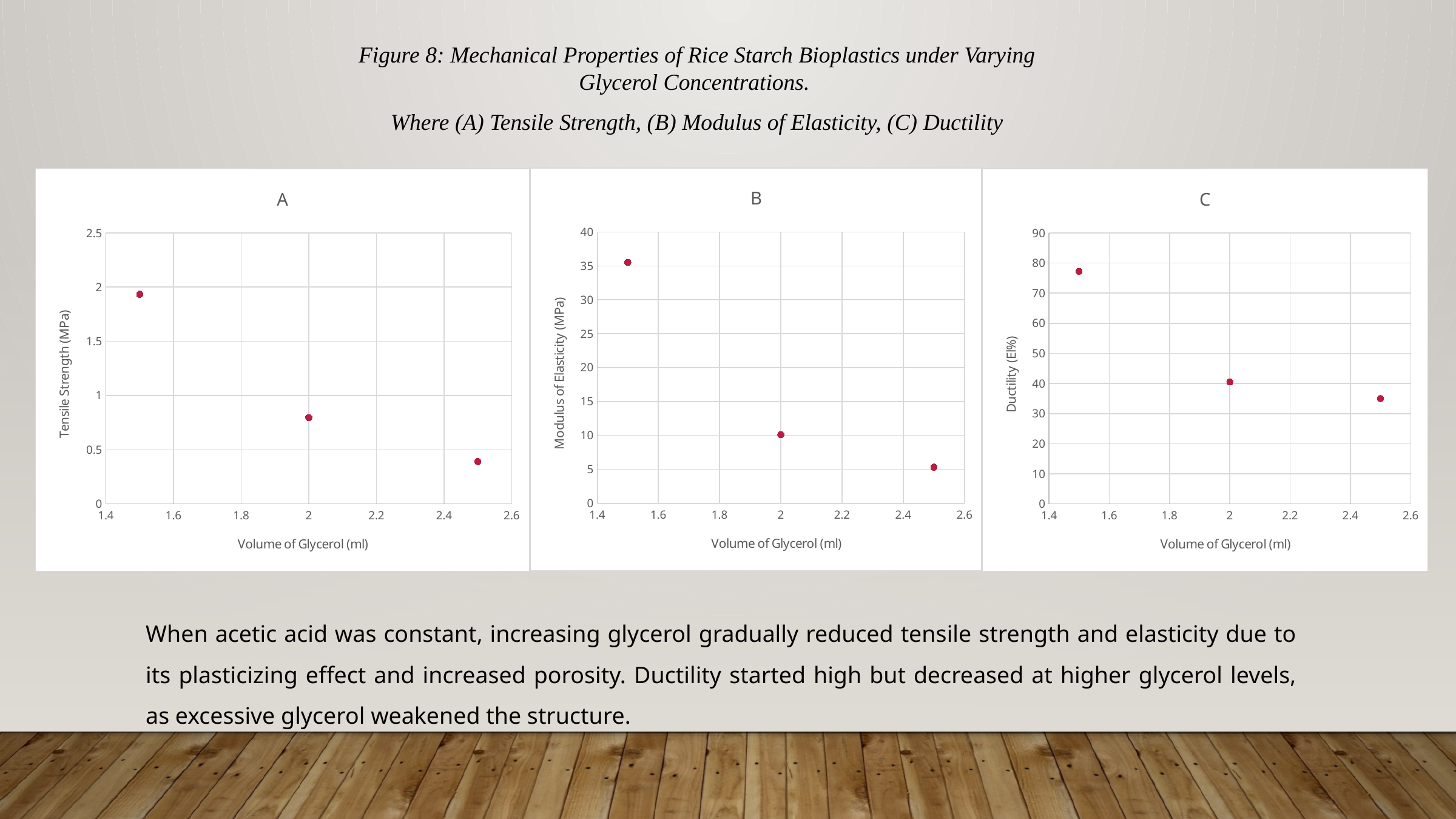
In chart C, is the ductility at 1.5 ml of glycerol greater or less than 70? greater In chart B, do the modulus of elasticity values rise or fall as the volume of glycerol increases? fall How many data points are plotted in chart B? 3 In chart C, at which volume of glycerol is ductility highest? 1.5 In chart A, is the tensile strength at 1.5 ml of glycerol greater or less than 1.5 MPa? greater In chart B, at which volume of glycerol is the modulus of elasticity lowest? 2.5 What kind of chart is chart A? scatter chart What is the x-axis label of chart C? Volume of Glycerol (ml) In chart B, is the modulus of elasticity at 1.5 ml of glycerol greater or less than 30 MPa? greater In chart C, do the ductility values rise or fall as the volume of glycerol increases? fall In chart A, do the tensile strength values rise or fall as the volume of glycerol increases? fall